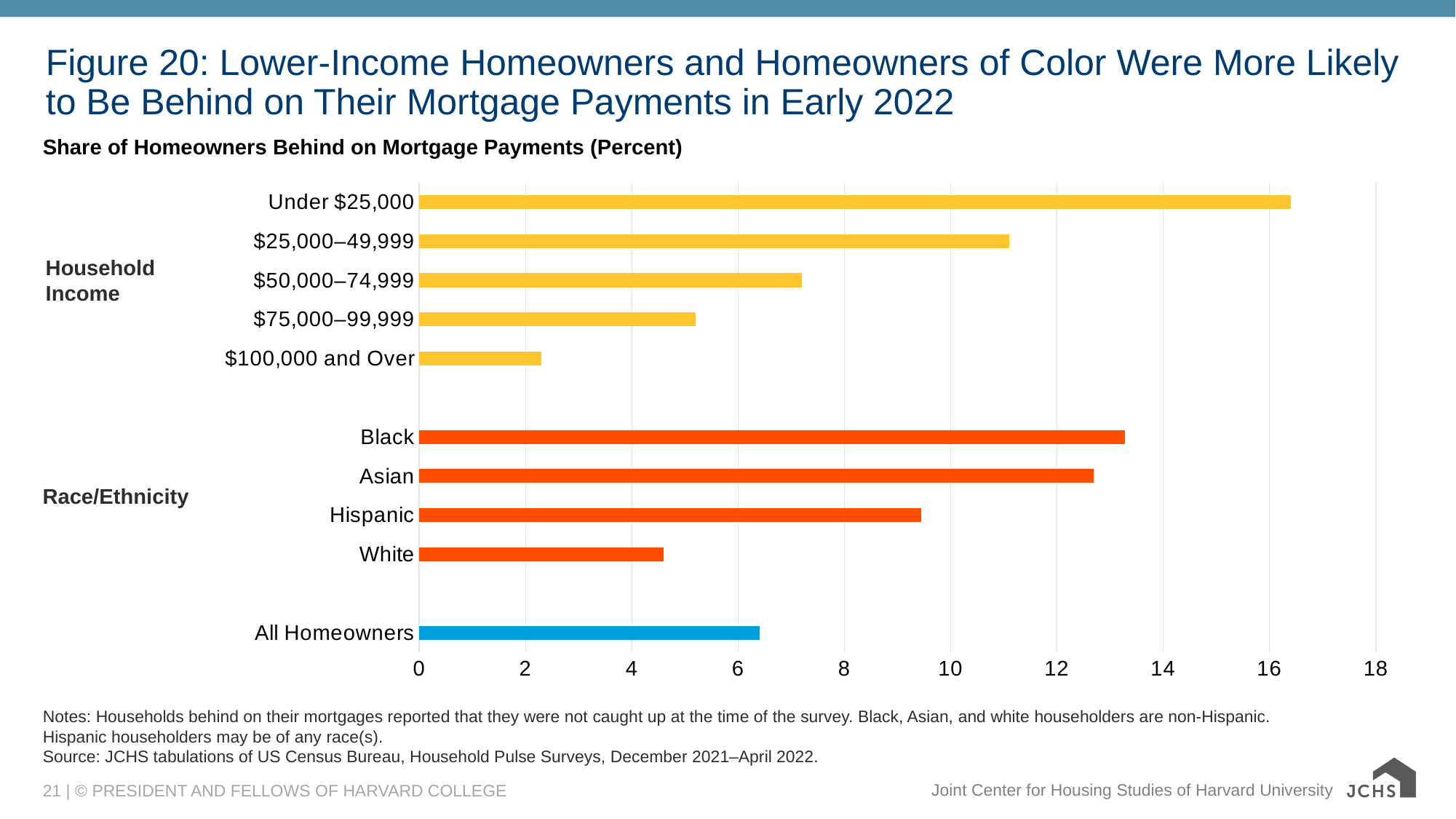
Which is larger, the value for $25,000–49,999 or the value for $50,000–74,999? $25,000–49,999 Which category has the highest share of homeowners behind on mortgage payments? Under $25,000 Moving from the lowest to the highest household income group, do the values rise or fall? fall Is the value for Under $25,000 greater or less than 16? greater What kind of chart is shown on the slide? bar chart What is the subtitle describing the measure plotted in the chart? Share of Homeowners Behind on Mortgage Payments (Percent) Is the value for All Homeowners greater or less than 8? less Which category has the lowest share of homeowners behind on mortgage payments? $100,000 and Over How many categories (bars) are plotted in the chart? 10 Is the value for Hispanic greater or less than 8? greater Which is larger, the value for Hispanic or the value for White? Hispanic